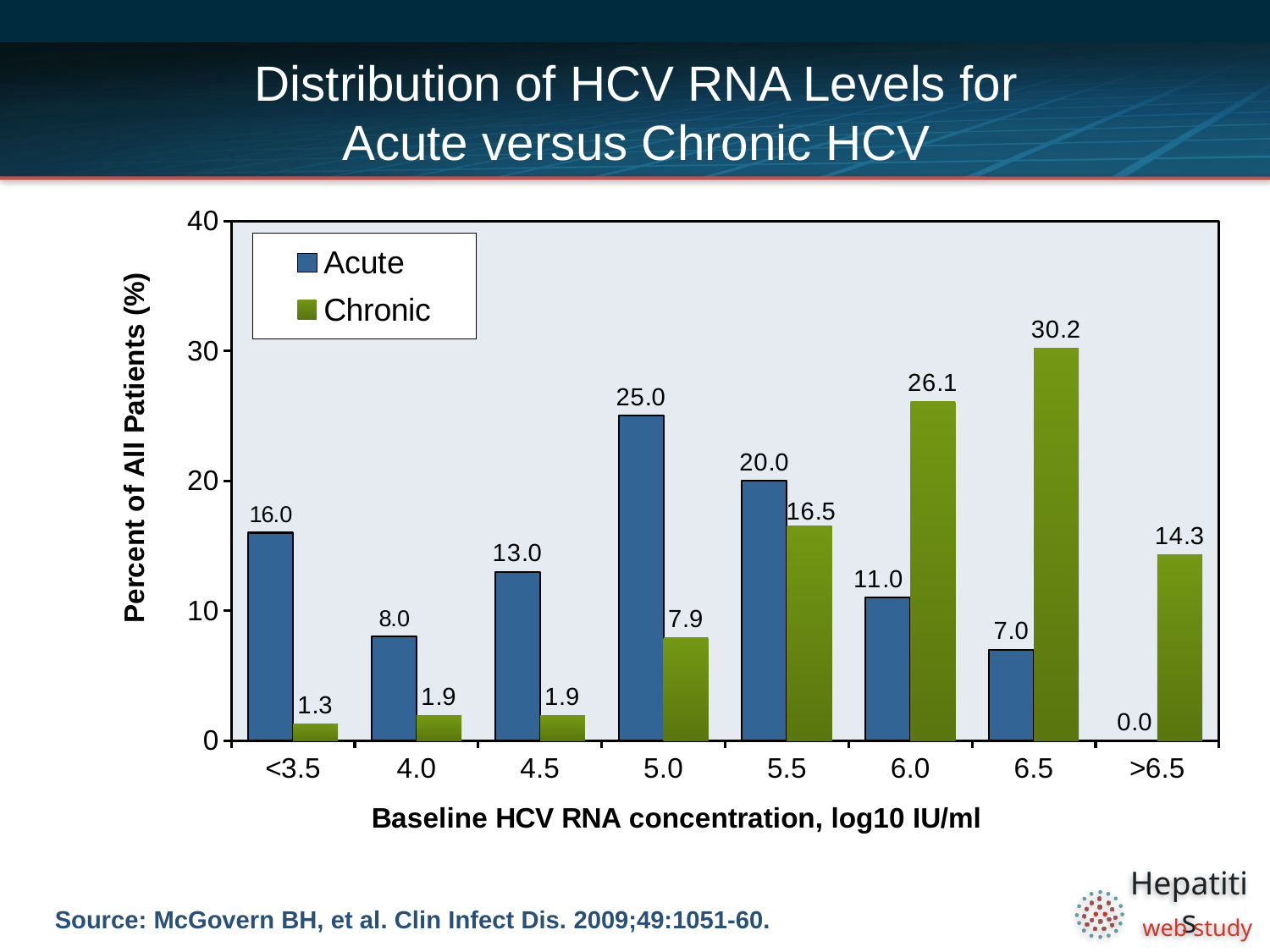
What is the Acute value for the 5.0 log10 IU/ml category? 25.0 At 5.5, which series has the larger value, Acute or Chronic? Acute Which category has the highest Chronic value? 6.5 Which category has the lowest Chronic value? <3.5 What is the Acute value for the >6.5 category? 0.0 How many series does the legend list? 2 What is the Chronic value for the 6.5 log10 IU/ml category? 30.2 What kind of chart is shown on the slide? Bar chart How many categories are shown on the x axis? 8 What is the difference between the Chronic and Acute values at 6.0? 15.1 What is the label of the y axis? Percent of All Patients (%) Which category has the highest Acute value? 5.0